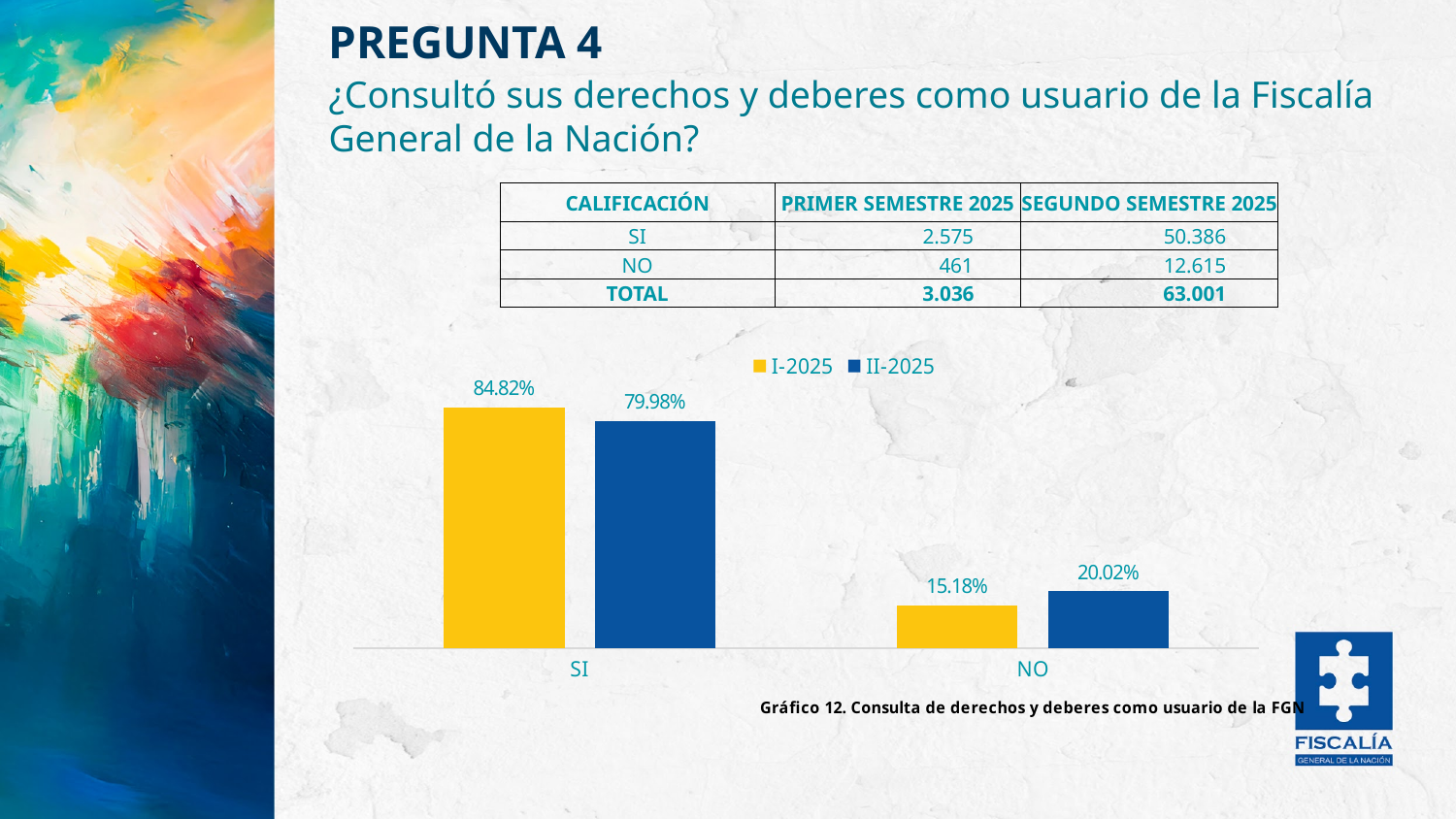
How many categories are shown on the x axis? 2 What is the value for NO in the II-2025 series? 20.02% For the NO category, which series has the larger value, I-2025 or II-2025? II-2025 What is the value for SI in the I-2025 series? 84.82% What is the difference between the II-2025 and I-2025 values for NO? 4.84 percentage points What is the value for NO in the I-2025 series? 15.18% How many series does the legend list? 2 Which category has the highest value in the I-2025 series? SI Which category has the lowest value in the II-2025 series? NO What is the value for SI in the II-2025 series? 79.98% What type of chart is shown on the slide? Bar chart What is the difference between the I-2025 and II-2025 values for SI? 4.84 percentage points